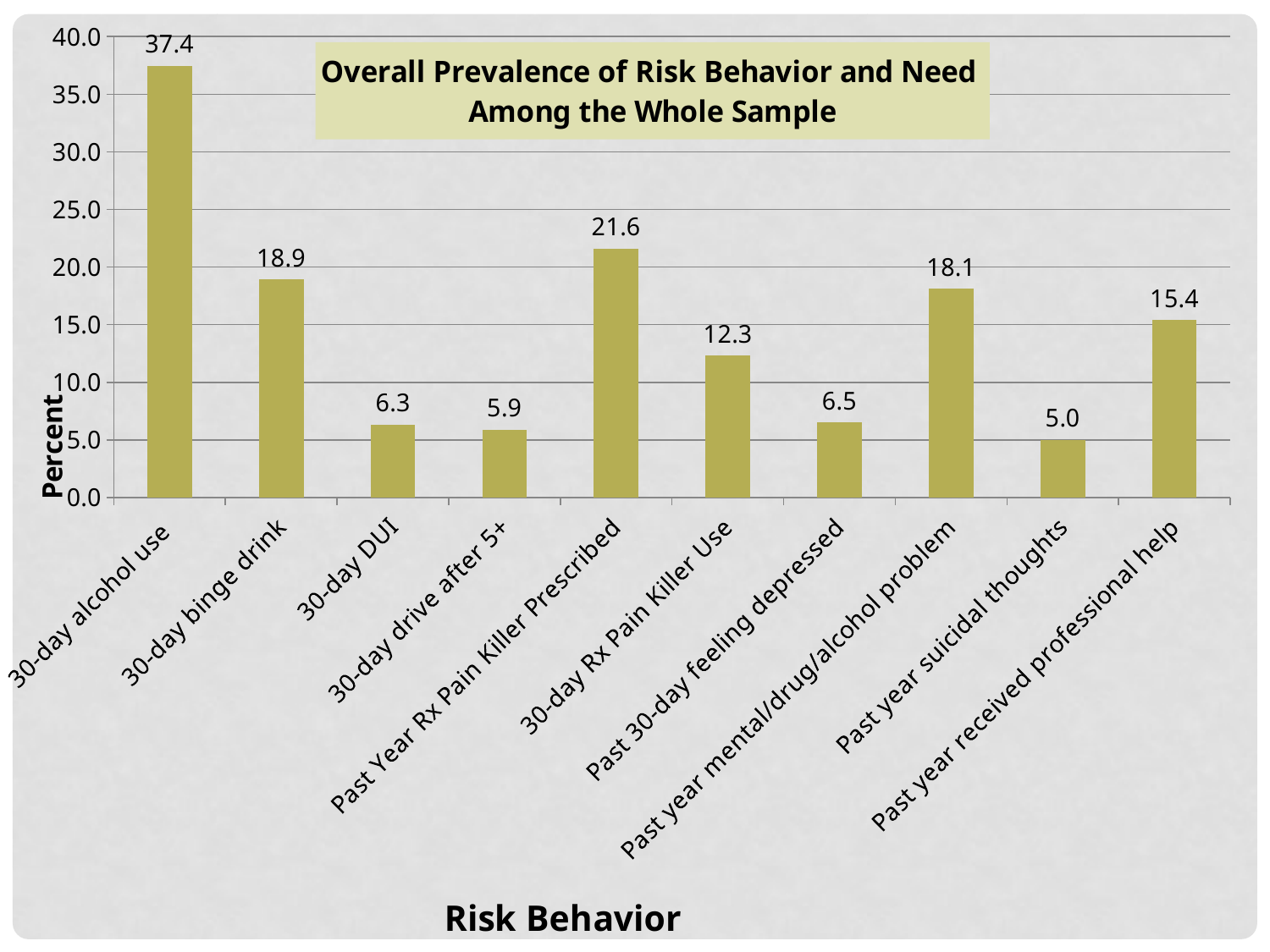
Which risk behavior has the lowest value? Past year suicidal thoughts Is the value for Past 30-day feeling depressed greater or less than 10.0? less What is the value for Past year received professional help? 15.4 Which is larger, the value for 30-day Rx Pain Killer Use or the value for Past year mental/drug/alcohol problem? Past year mental/drug/alcohol problem What is the label of the vertical axis? Percent What is the difference between the values for 30-day binge drink and 30-day DUI? 12.6 What is the value for Past Year Rx Pain Killer Prescribed? 21.6 How many risk behavior categories are shown on the chart? 10 What kind of chart is shown on the slide? bar chart What is the title of the chart? Overall Prevalence of Risk Behavior and Need Among the Whole Sample Which risk behavior has the highest value? 30-day alcohol use What is the value for 30-day alcohol use? 37.4